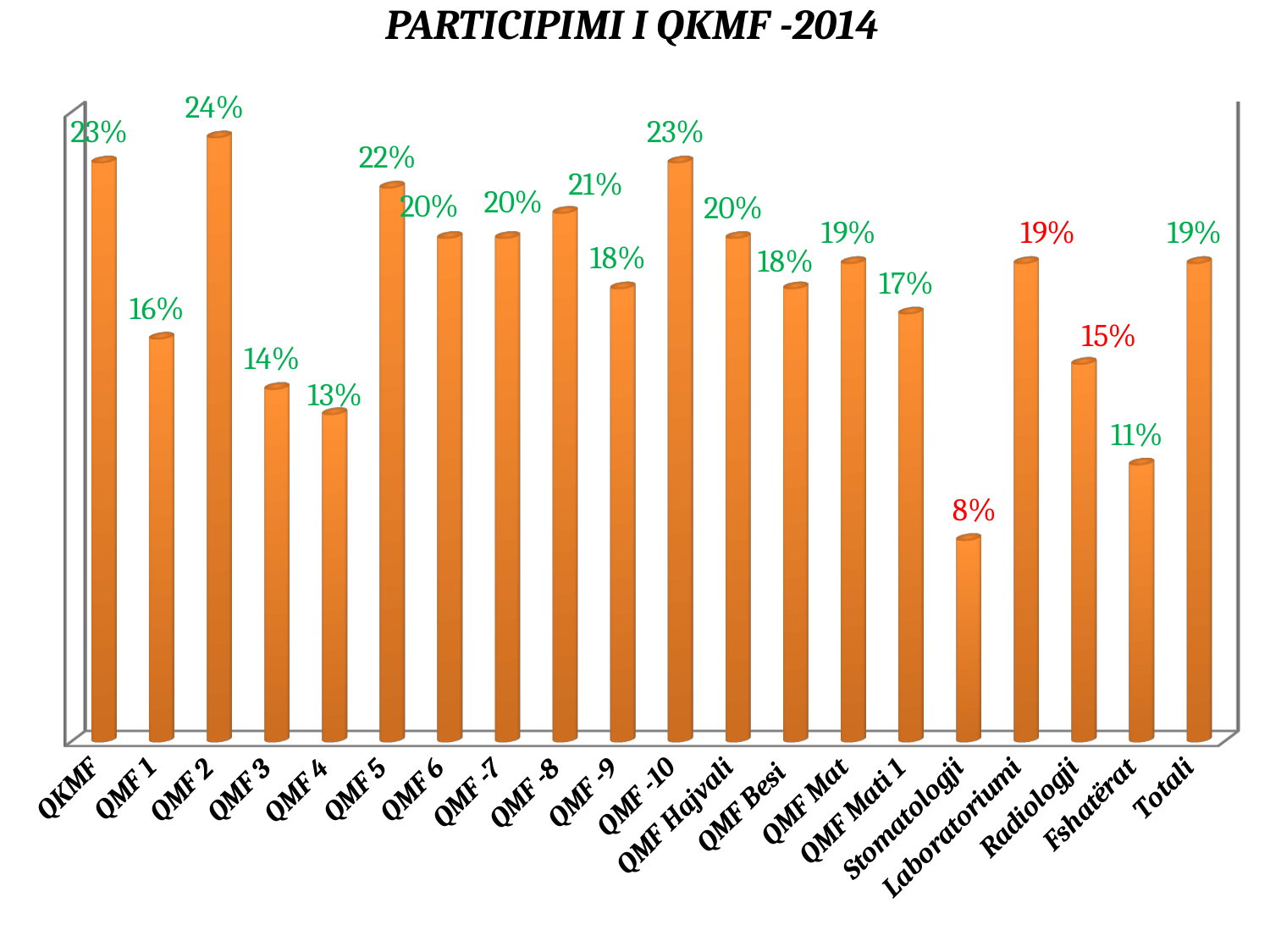
What is the value for Fshatërat? 11% What is the value for Stomatologji? 8% What is the value for Totali? 19% What is the difference between the values for QMF 2 and Stomatologji? 16% Which category has the lowest value? Stomatologji Which category has the highest value? QMF 2 Which is larger, the value for QMF 1 or the value for Radiologji? QMF 1 What kind of chart is shown on the slide? Bar chart What is the title of the chart? PARTICIPIMI I QKMF -2014 What is the difference between the values for QMF 5 and QMF 4? 9% What is the value for QMF 2? 24% How many categories are shown on the x axis? 20